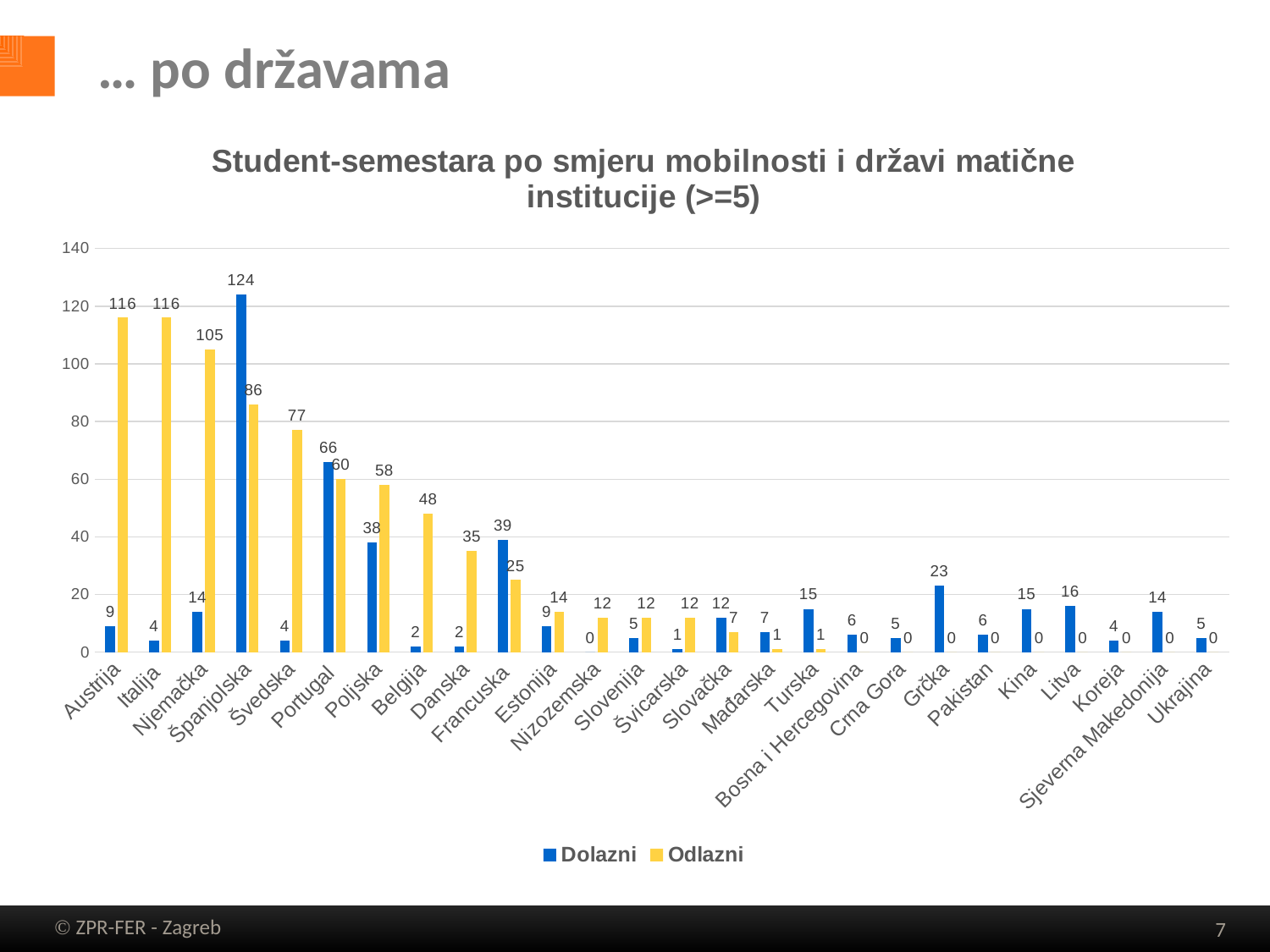
What is the difference between the Dolazni and Odlazni values for Portugal? 6 How many series does the legend list? 2 Is the Odlazni value for Švedska greater or less than 60? greater Which country has the highest Dolazni value? Španjolska How many countries are shown on the x axis? 26 What is the Odlazni value for Belgija? 48 What is the Dolazni value for Španjolska? 124 What is the Odlazni value for Njemačka? 105 Which is larger for Francuska, the Dolazni value or the Odlazni value? Dolazni Which country has the lowest Odlazni value among Austrija, Italija and Njemačka? Njemačka What kind of chart is shown on the slide? Bar chart Which colour represents the Odlazni series? Yellow